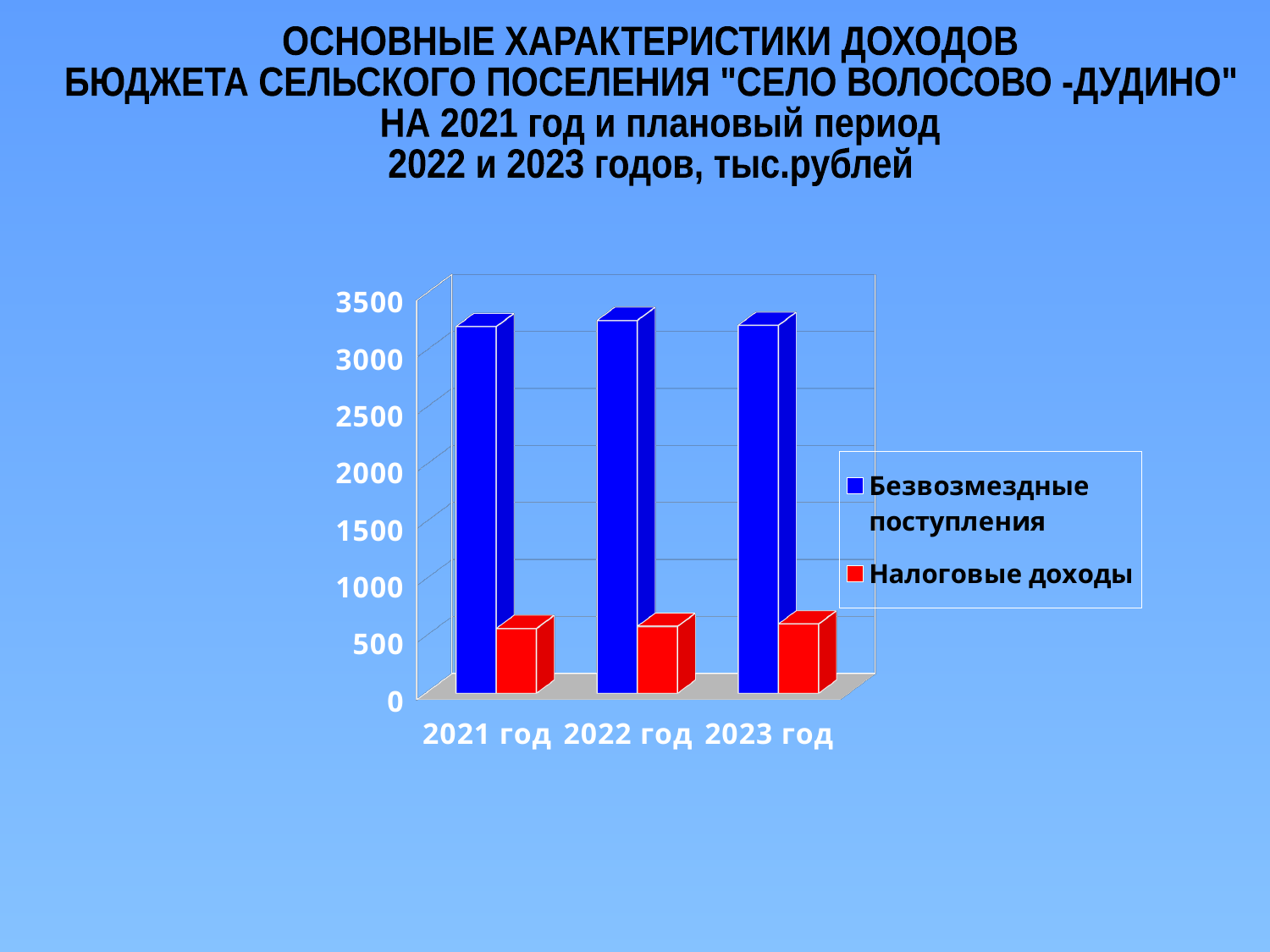
What is the first entry listed in the legend? Безвозмездные поступления Is the value for Безвозмездные поступления in 2022 год greater or less than 3500? less Which series is shown in red? Налоговые доходы Which series is larger in 2023 год: Безвозмездные поступления or Налоговые доходы? Безвозмездные поступления Which series is larger in 2021 год: Безвозмездные поступления or Налоговые доходы? Безвозмездные поступления What kind of chart is shown on the slide? bar chart How many series does the legend list? 2 Is the value for Безвозмездные поступления in 2023 год greater or less than 2500? greater Is the value for Налоговые доходы in 2022 год greater or less than 1000? less How many year categories are shown on the x axis? 3